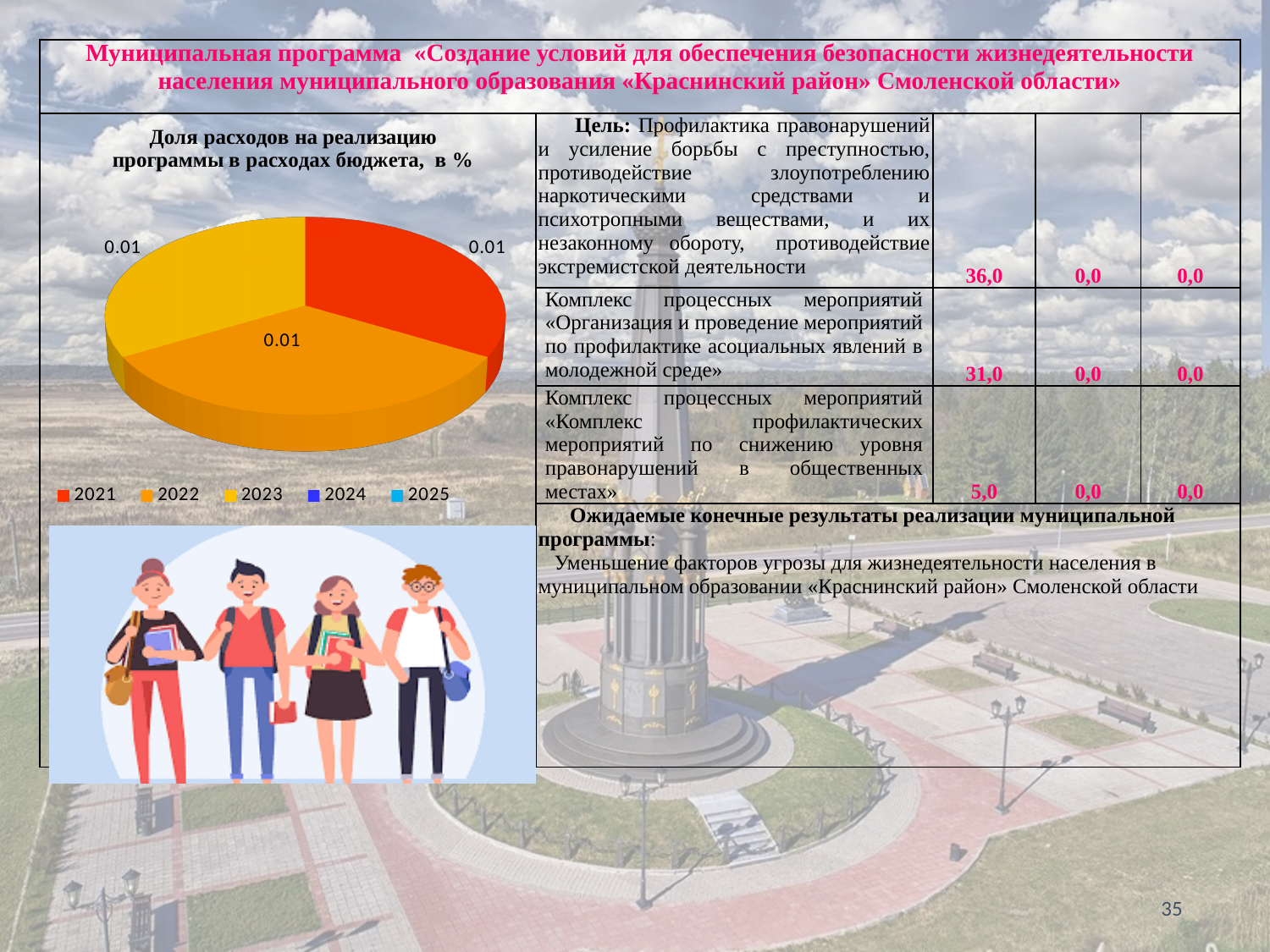
What value is labelled on the 2021 slice of the pie chart? 0.01 How many entries does the legend of the pie chart list? 5 Which years are listed in the legend of the pie chart? 2021, 2022, 2023, 2024, 2025 What kind of chart is shown on the left of the slide? pie chart Is the labelled value for 2022 in the pie chart greater or less than 1? less How many slices with data labels are visible in the pie chart? 3 What is the title of the pie chart? Доля расходов на реализацию программы в расходах бюджета, в % What is the difference between the labelled values for 2021 and 2023 in the pie chart? 0 What value is labelled on the 2023 slice of the pie chart? 0.01 What value is labelled on the 2022 slice of the pie chart? 0.01